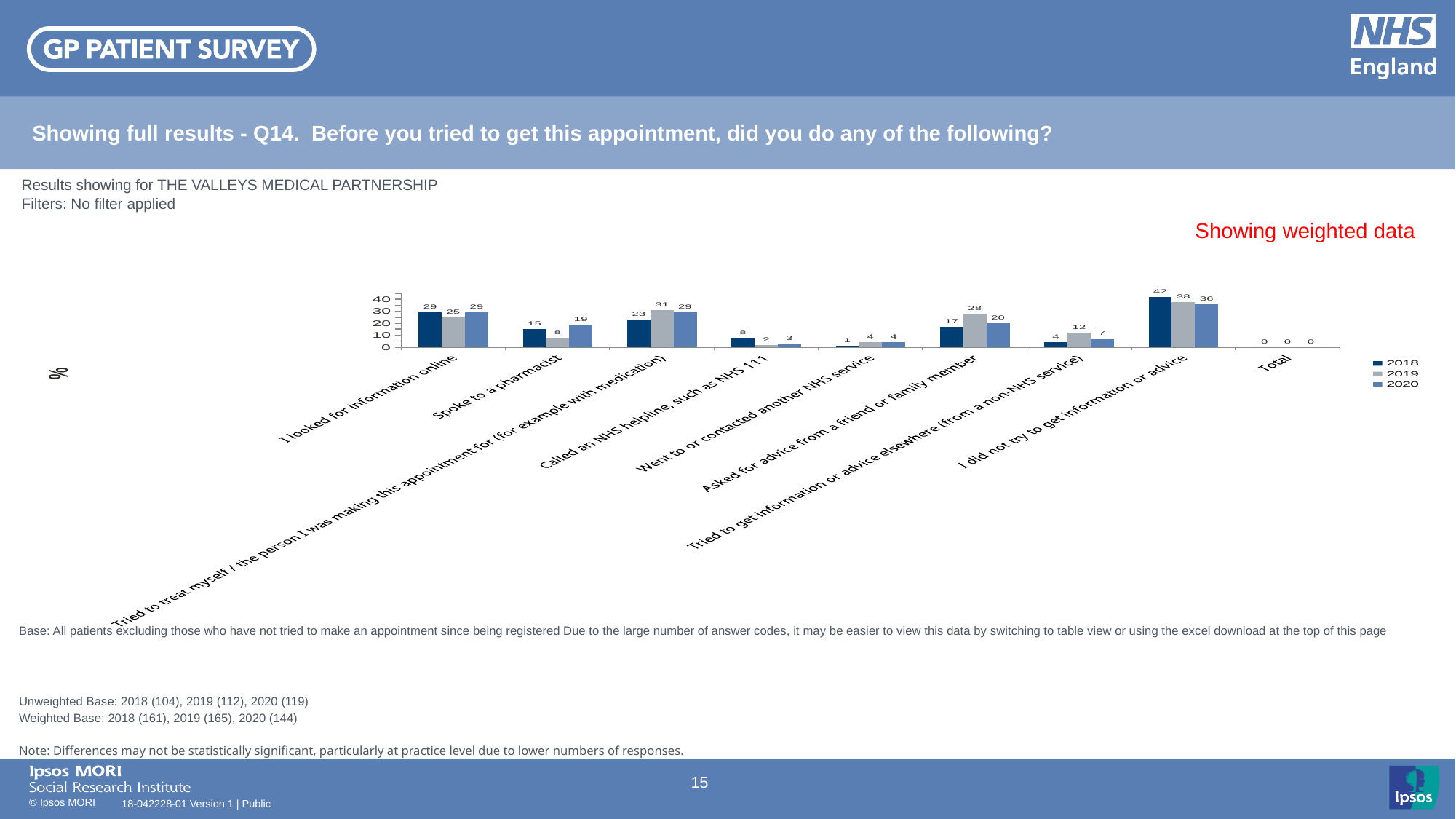
What is the 2019 value for 'Spoke to a pharmacist'? 8 What is the 2018 value for 'Asked for advice from a friend or family member'? 17 What kind of chart is shown on the slide? bar chart Which category has the lowest 2018 value, excluding Total? Went to or contacted another NHS service What is the 2020 value for 'I did not try to get information or advice'? 36 Which is larger for 'Called an NHS helpline, such as NHS 111': the 2018 value or the 2020 value? 2018 How many series does the legend list? 3 What are the three years listed in the legend? 2018, 2019, 2020 How does the value for 'I did not try to get information or advice' change from 2018 to 2020? It falls Which category has the highest 2018 value? I did not try to get information or advice What is the difference between the 2019 and 2018 values for 'Tried to get information or advice elsewhere (from a non-NHS service)'? 8 Is the 2019 value for 'Tried to treat myself / the person I was making this appointment for (for example with medication)' greater or less than 20? greater